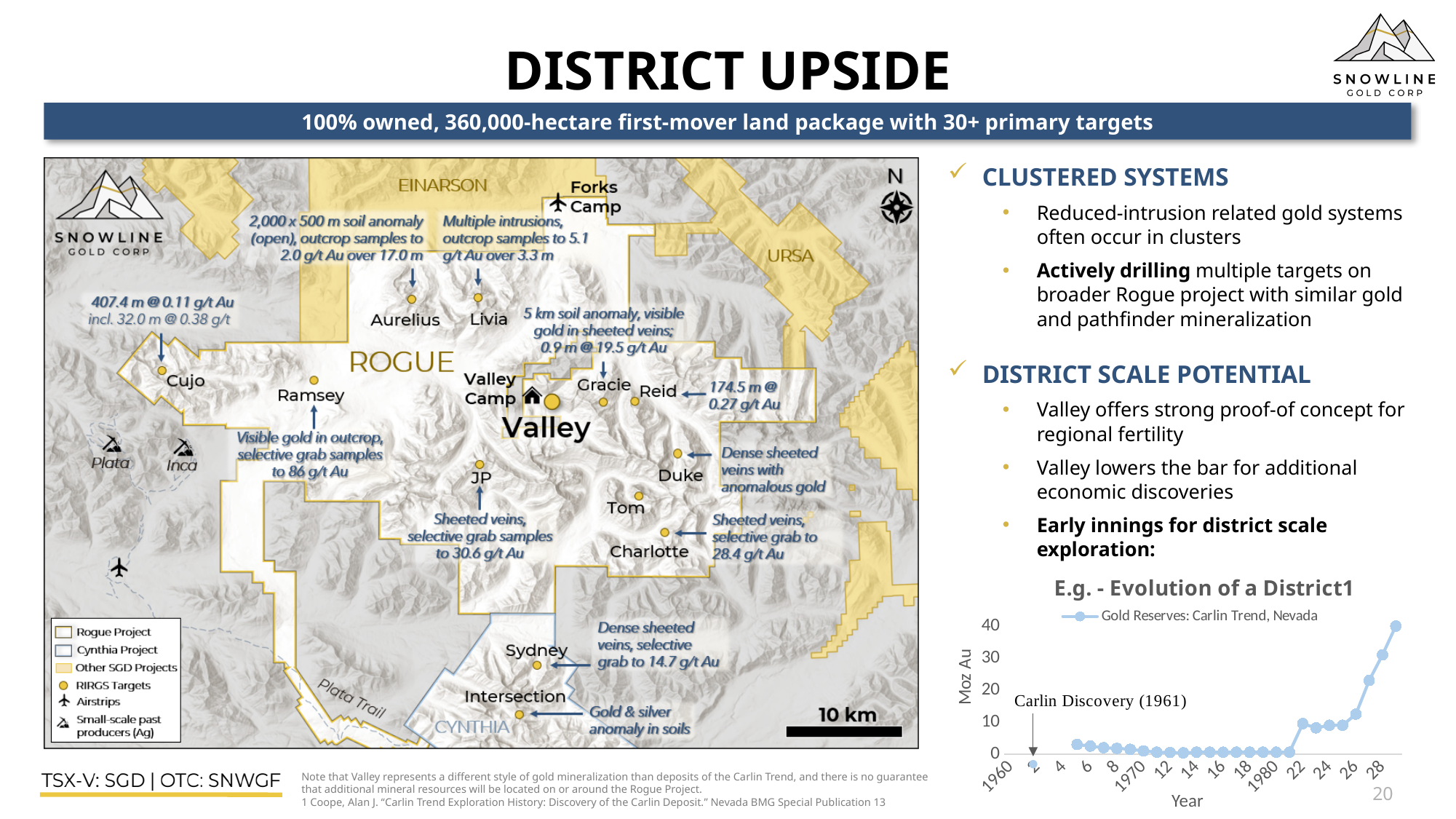
In the "Evolution of a District" chart, do gold reserves generally rise or fall from 1960 to the end of the series? rise In the "Evolution of a District" chart, is the value for 1984 greater or less than 20? less What is the y-axis label of the "Evolution of a District" chart? Moz Au In the "Evolution of a District" chart, is the value for 1970 greater or less than 10? less What is the name of the series in the legend of the "Evolution of a District" chart? Gold Reserves: Carlin Trend, Nevada In the "Evolution of a District" chart, which year has the larger value, 1970 or 1982? 1982 In the "Evolution of a District" chart, what year does the annotation mark as the Carlin Discovery? 1961 In the "Evolution of a District" chart, is the value for 1980 greater or less than 10? less In the "Evolution of a District" chart, which year has the larger value, 1980 or 1988? 1988 How many series does the legend of the "Evolution of a District" chart list? 1 What kind of chart is shown under "E.g. - Evolution of a District"? line chart